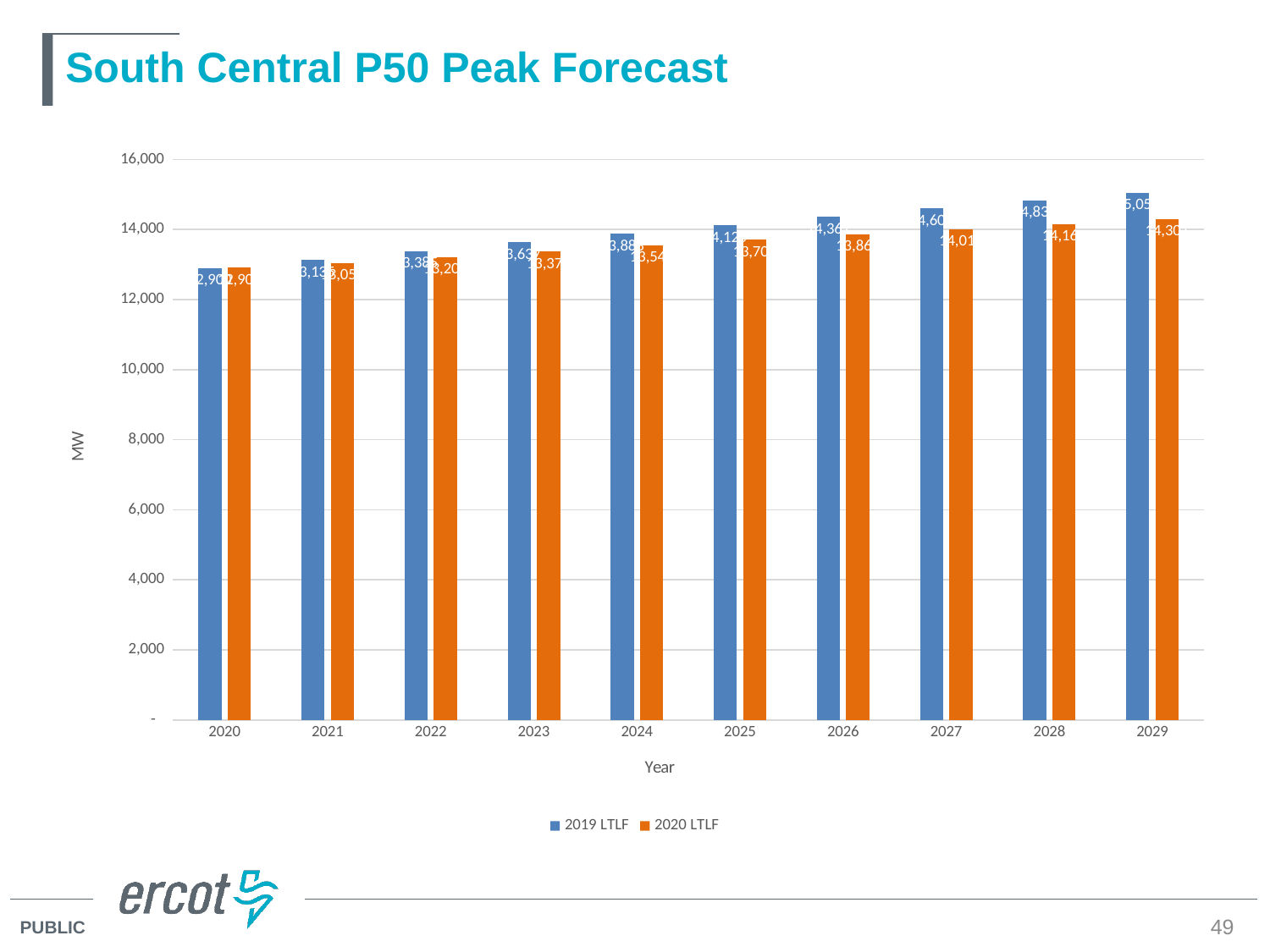
How many years are shown on the x axis? 10 How many series does the legend list? 2 What is the label on the y axis? MW What is the title of the chart? South Central P50 Peak Forecast Is the 2019 LTLF value for 2020 greater or less than 12,000? greater In 2029, which series has the larger value, 2019 LTLF or 2020 LTLF? 2019 LTLF Do the 2019 LTLF values rise or fall from 2020 to 2029? rise Which year has the lowest 2020 LTLF value? 2020 What kind of chart is shown on the slide? bar chart Is the 2019 LTLF value for 2029 greater or less than 14,000? greater Which year has the highest 2019 LTLF value? 2029 Is the 2020 LTLF value for 2025 greater or less than 14,000? less